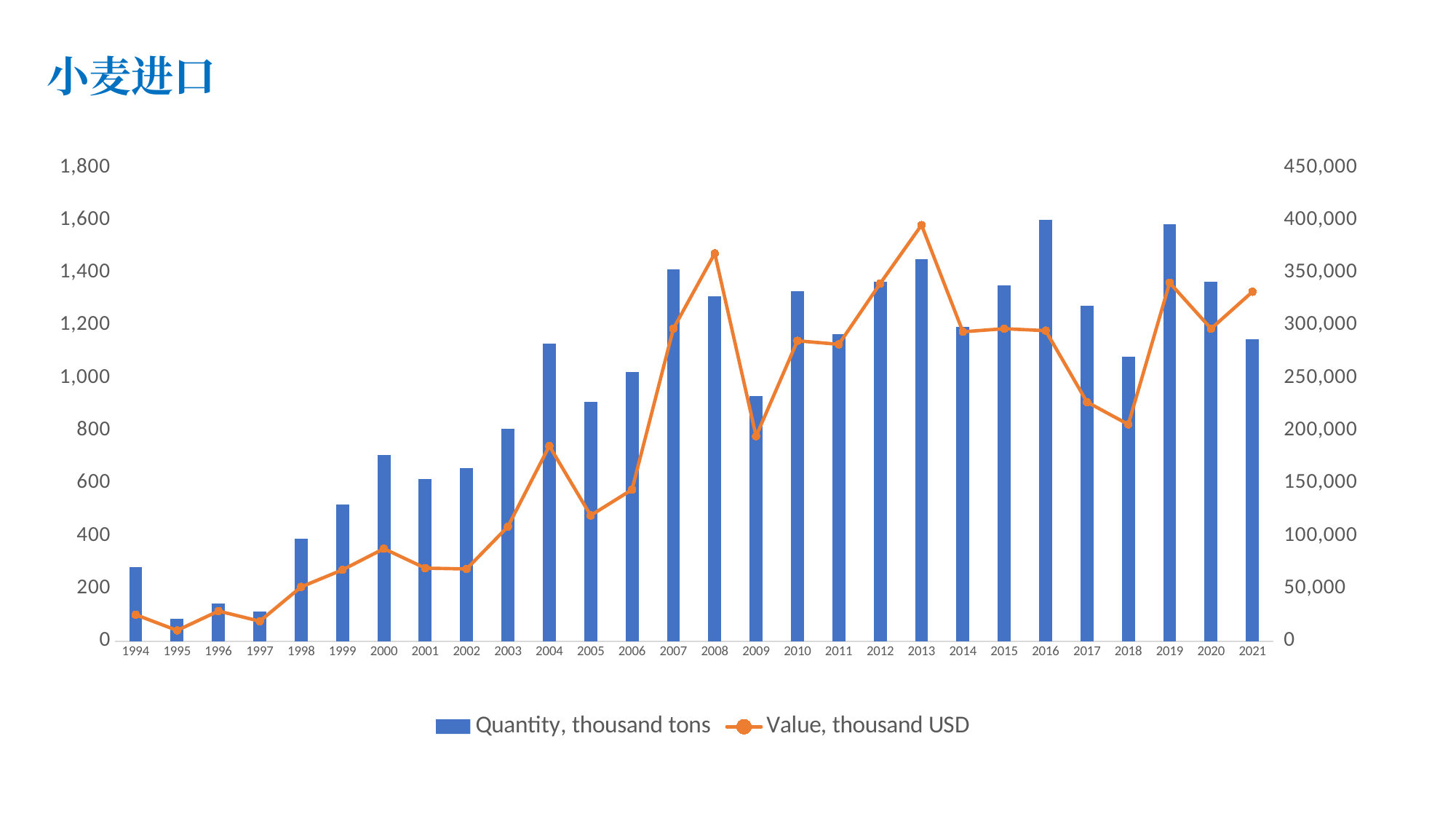
Which year has the highest Value, thousand USD? 2013 Which year has the larger Quantity, thousand tons: 1999 or 2000? 2000 Is the Quantity, thousand tons for 2004 greater or less than 1,000? greater Which year has the lowest Value, thousand USD? 1995 How many years are plotted along the x axis? 28 What is the title of the slide? 小麦进口 Is the Value, thousand USD for 2008 greater or less than 350,000? greater Is the Value, thousand USD for 2018 greater or less than 250,000? less Which year has the lowest Quantity, thousand tons? 1995 Does the Quantity, thousand tons rise or fall from 1997 to 2004? rise How many series does the legend list? 2 What kind of chart is shown on the slide? A combined bar and line chart